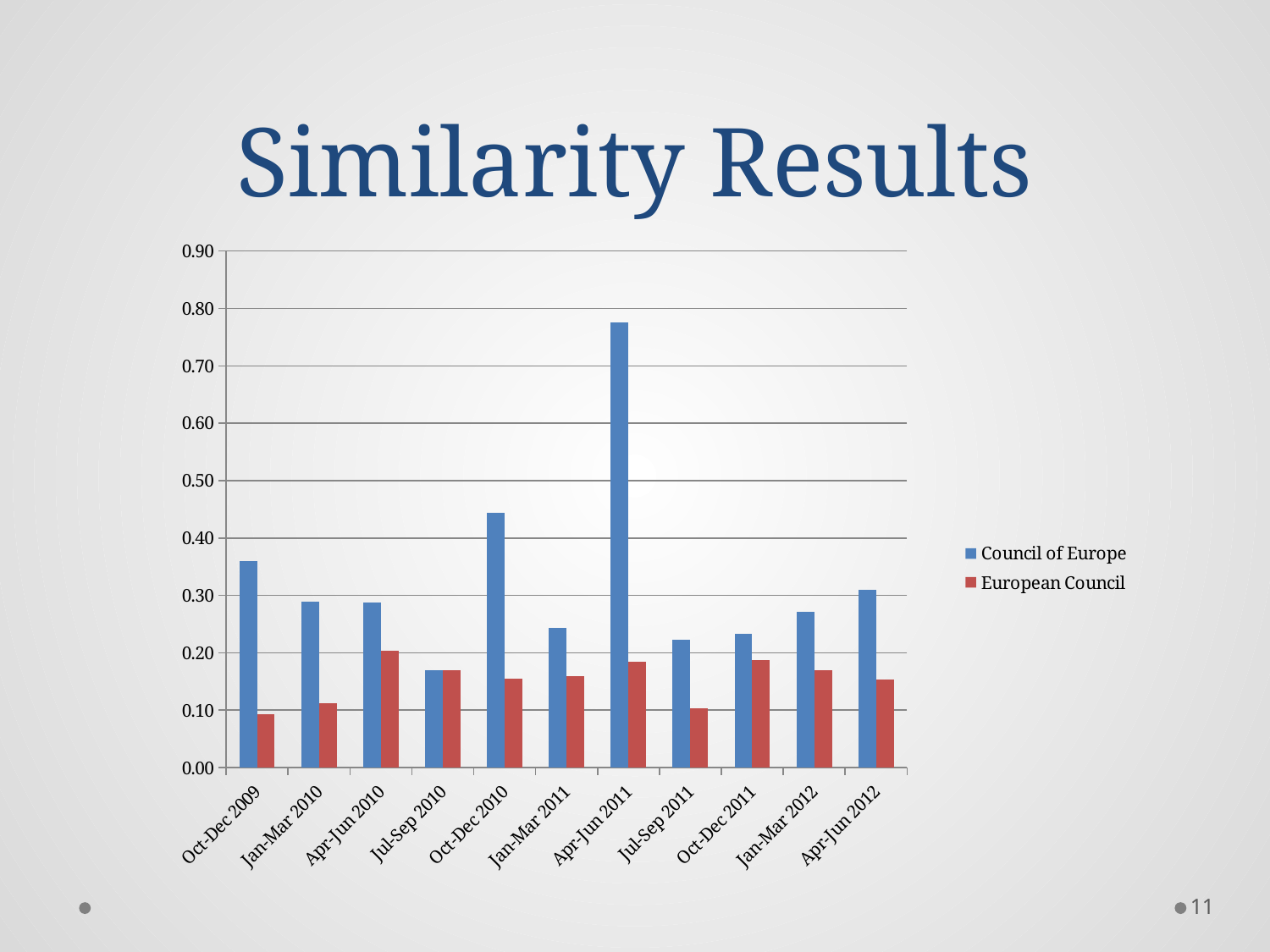
How many time periods are shown on the x axis? 11 Is the value for Council of Europe in Oct-Dec 2010 greater or less than 0.40? greater In Oct-Dec 2010, which series has the larger value, Council of Europe or European Council? Council of Europe Which period has the highest value for Council of Europe? Apr-Jun 2011 Which period has the lowest value for Council of Europe? Jul-Sep 2010 How many series does the legend list? 2 What is the title of the chart slide? Similarity Results Which period has the lowest value for European Council? Oct-Dec 2009 What kind of chart is shown on the slide? bar chart Is the value for Council of Europe in Apr-Jun 2011 greater or less than 0.70? greater Is the value for Council of Europe in Oct-Dec 2009 greater or less than 0.30? greater